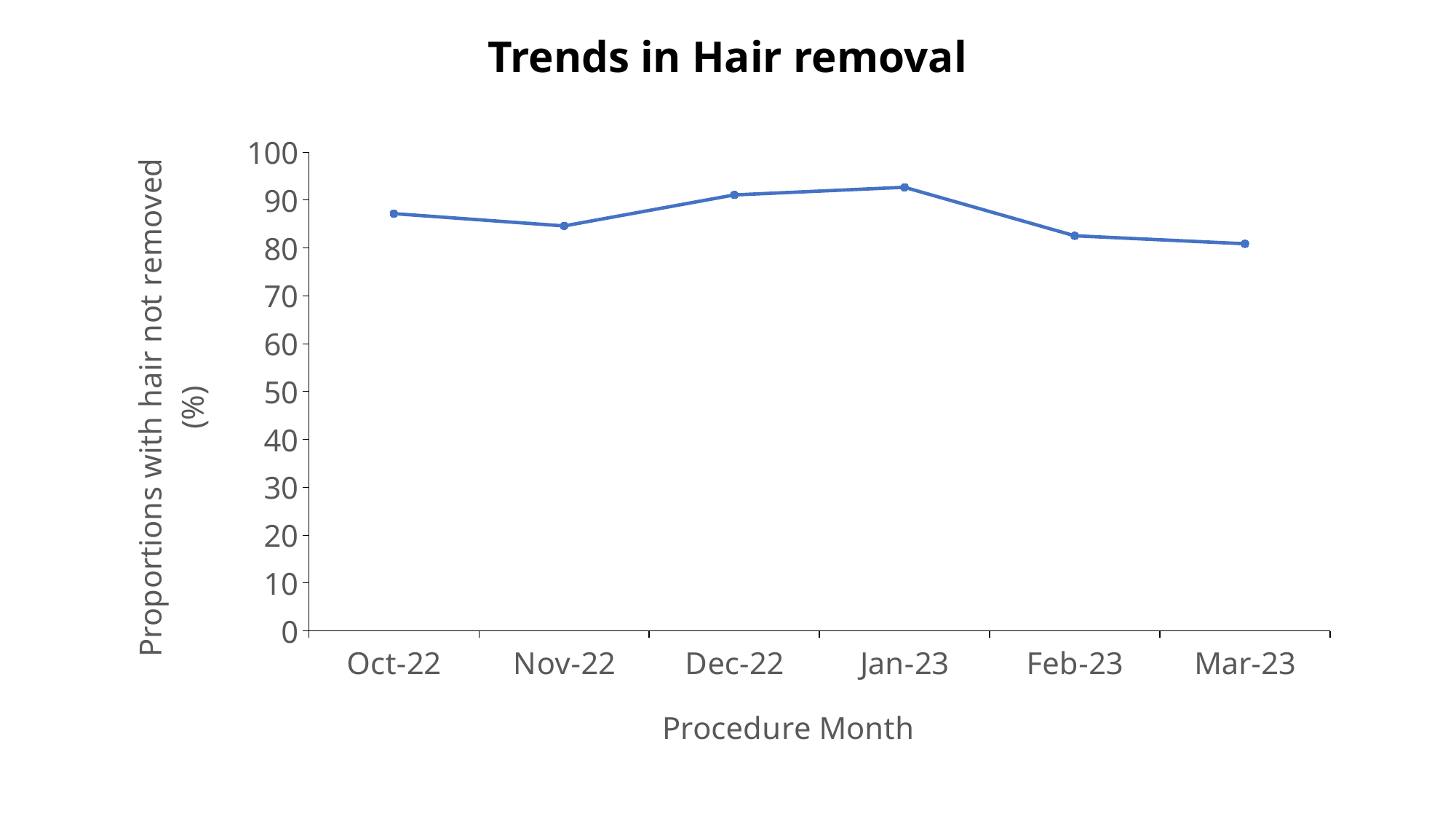
What is the label of the x axis? Procedure Month How many months are plotted on the x axis? 6 Do the values rise or fall from Jan-23 to Mar-23? fall Which is larger, the value for Jan-23 or the value for Feb-23? Jan-23 Is the value for Feb-23 greater or less than 90? less Is the value for Jan-23 greater or less than 90? greater What kind of chart is shown on the slide? line chart Which is larger, the value for Nov-22 or the value for Dec-22? Dec-22 Is the value for Nov-22 greater or less than 90? less Do the values rise or fall from Nov-22 to Jan-23? rise What is the title of the chart? Trends in Hair removal